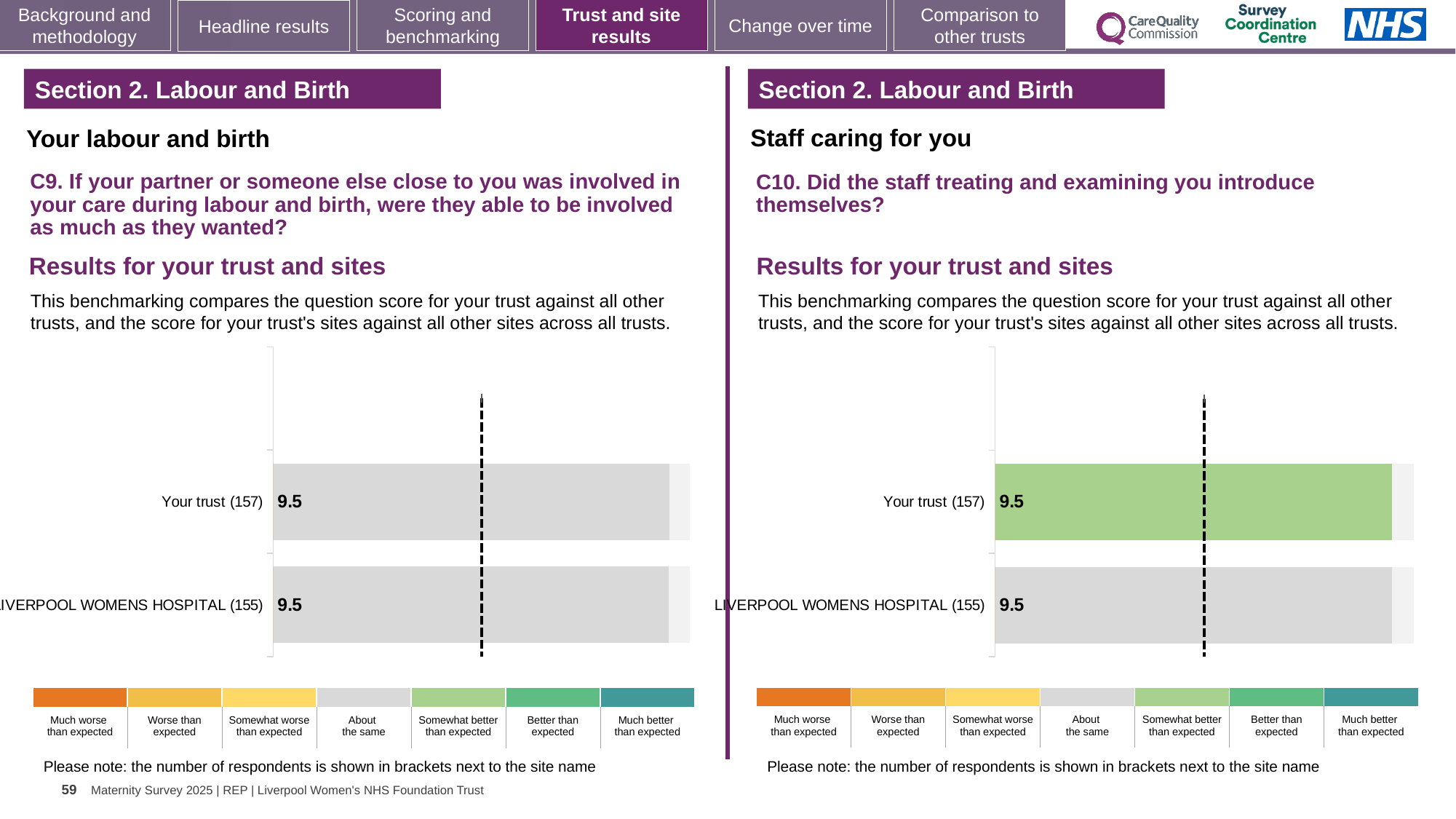
What kind of chart is used in the left chart (C9)? Bar chart In the left chart (C9), what is the difference between the score for Your trust and the score for LIVERPOOL WOMENS HOSPITAL? 0 In the right chart (C10), what is the score for LIVERPOOL WOMENS HOSPITAL? 9.5 In the right chart (C10), how many respondents are shown in brackets for Your trust? 157 How many bars are plotted in the left chart (C9)? 2 In the right chart (C10), which benchmark category does the green colour of the Your trust bar correspond to in the legend? Somewhat better than expected In the left chart (C9), what is the score for LIVERPOOL WOMENS HOSPITAL? 9.5 How many bars are plotted in the right chart (C10)? 2 In the right chart (C10), what is the score for Your trust? 9.5 In the left chart (C9), how many respondents are shown in brackets for LIVERPOOL WOMENS HOSPITAL? 155 In the left chart (C9), what is the score for Your trust? 9.5 In the left chart (C9), which benchmark category does the grey colour of the bars correspond to in the legend? About the same